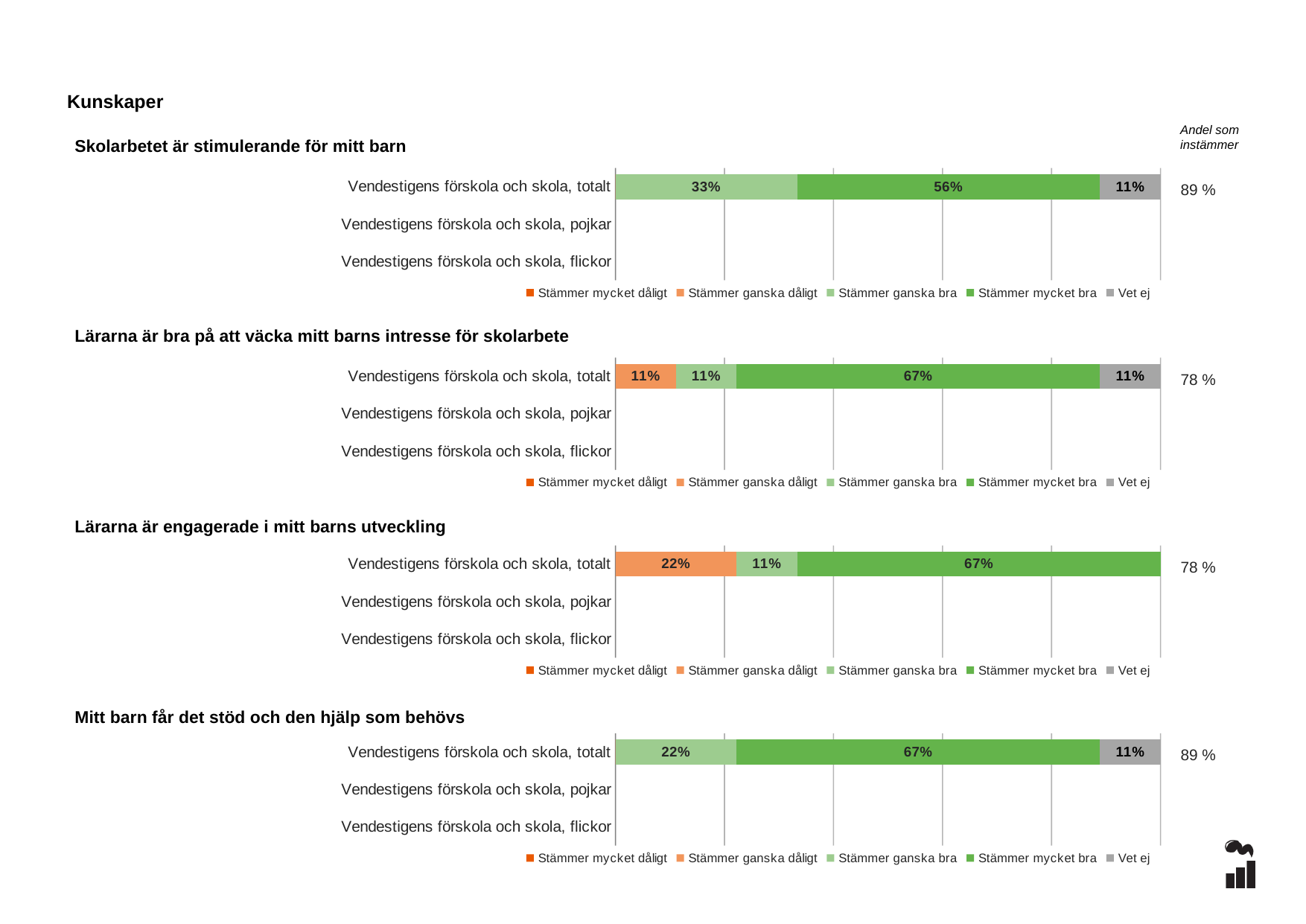
How many series does the legend list in the chart 'Skolarbetet är stimulerande för mitt barn'? 5 In the chart 'Mitt barn får det stöd och den hjälp som behövs', what is the total of the 'Vendestigens förskola och skola, totalt' stacked bar? 100% What kind of chart is 'Mitt barn får det stöd och den hjälp som behövs'? Stacked bar chart In the chart 'Lärarna är bra på att väcka mitt barns intresse för skolarbete', what is the value of 'Stämmer mycket bra' for 'Vendestigens förskola och skola, totalt'? 67% In the chart 'Lärarna är engagerade i mitt barns utveckling', what is the value of 'Stämmer ganska dåligt' for 'Vendestigens förskola och skola, totalt'? 22% In the chart 'Mitt barn får det stöd och den hjälp som behövs', what is the value of 'Vet ej' for 'Vendestigens förskola och skola, totalt'? 11% In the chart 'Lärarna är bra på att väcka mitt barns intresse för skolarbete', what is the value of 'Stämmer ganska dåligt' for 'Vendestigens förskola och skola, totalt'? 11% In the chart 'Lärarna är engagerade i mitt barns utveckling', what is the difference between 'Stämmer mycket bra' and 'Stämmer ganska dåligt' for the 'totalt' bar? 45% How many categories are shown on the y axis of the chart 'Lärarna är engagerade i mitt barns utveckling'? 3 In the chart 'Skolarbetet är stimulerande för mitt barn', what is the value of 'Stämmer ganska bra' for 'Vendestigens förskola och skola, totalt'? 33% In the chart 'Skolarbetet är stimulerande för mitt barn', what is the value of 'Stämmer mycket bra' for 'Vendestigens förskola och skola, totalt'? 56% In the chart 'Skolarbetet är stimulerande för mitt barn', which segment of the 'totalt' bar is larger: 'Stämmer ganska bra' or 'Stämmer mycket bra'? Stämmer mycket bra